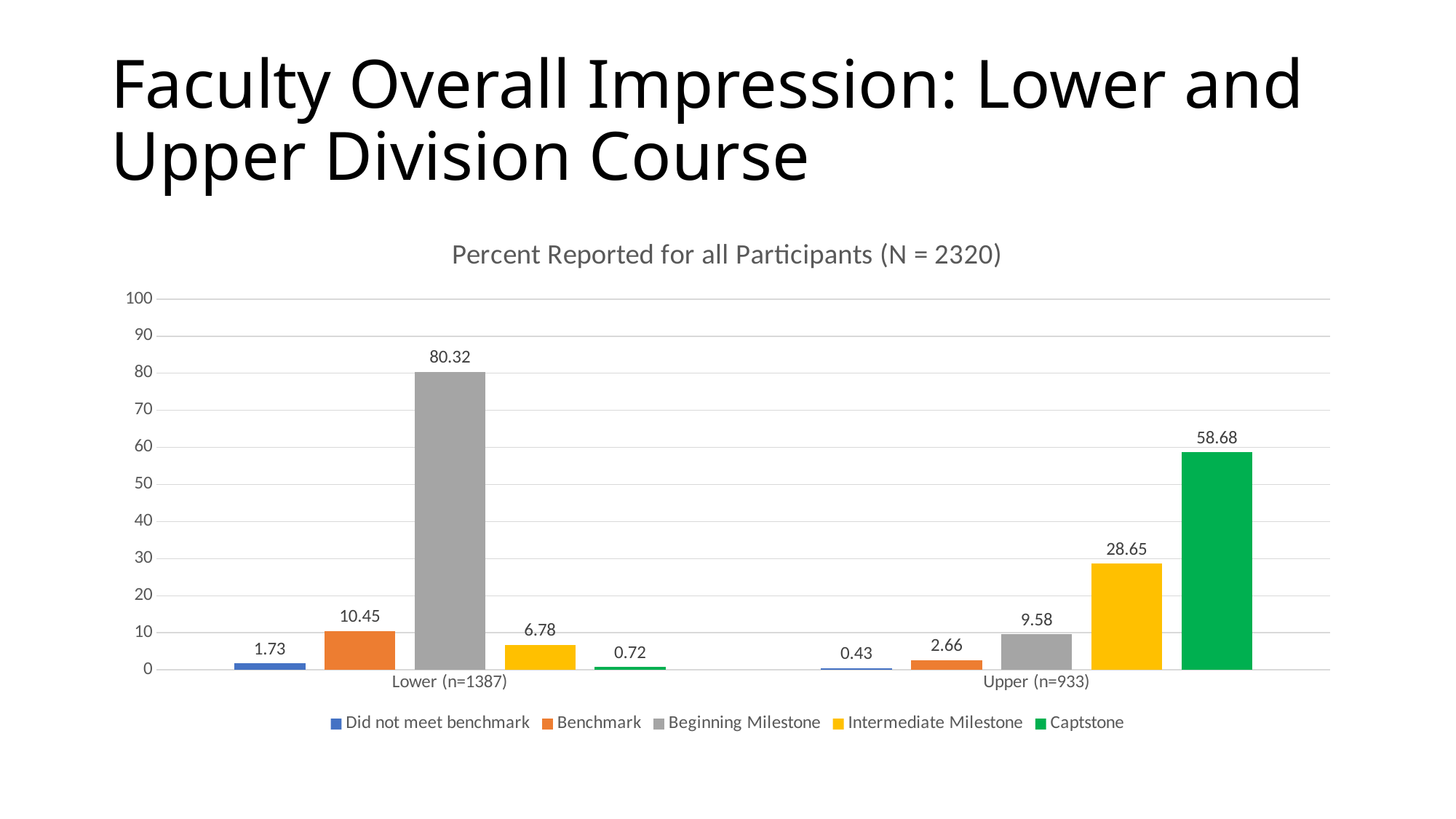
What is the value for Captstone in the Upper (n=933) group? 58.68 What is the title of the chart? Percent Reported for all Participants (N = 2320) What kind of chart is shown on the slide? Bar chart What is the difference between the Beginning Milestone values for Lower (n=1387) and Upper (n=933)? 70.74 How many series does the legend list? 5 What is the value for Intermediate Milestone in the Upper (n=933) group? 28.65 Which is larger: Intermediate Milestone for Lower (n=1387) or Intermediate Milestone for Upper (n=933)? Upper (n=933) What is the value for Beginning Milestone in the Lower (n=1387) group? 80.32 How many categories are shown on the x axis? 2 Which series has the lowest value in the Lower (n=1387) group? Captstone Which series has the highest value in the Upper (n=933) group? Captstone What is the value for Benchmark in the Lower (n=1387) group? 10.45